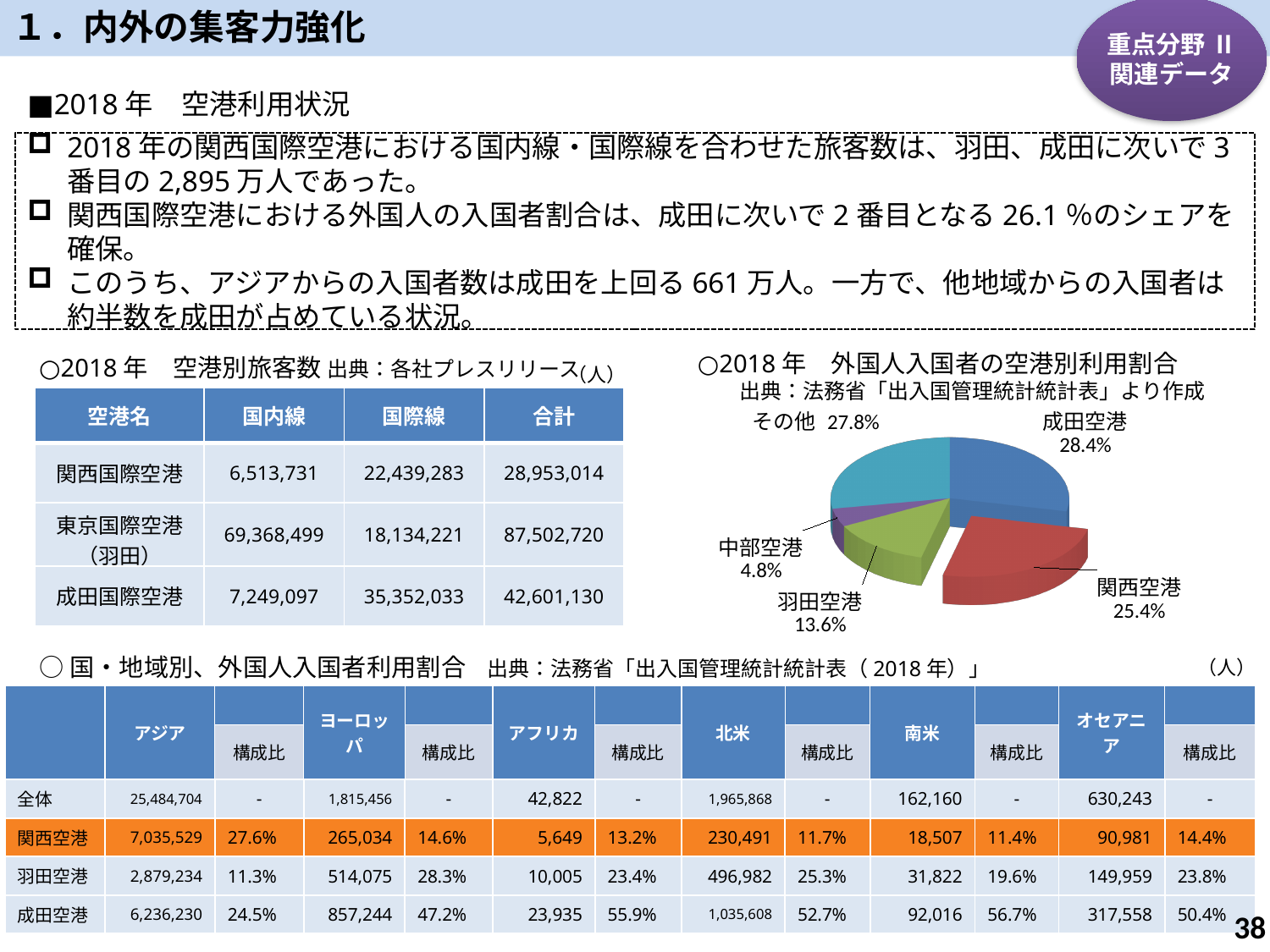
Which slice of the pie chart is the smallest? 中部空港 What is the value shown for 羽田空港 in the pie chart? 13.6% What is the value shown for その他 in the pie chart? 27.8% In the pie chart, what is the difference between the shares of 成田空港 and 関西空港? 3.0% What is the title of the pie chart? 2018年 外国人入国者の空港別利用割合 What share of the pie chart does 成田空港 account for? 28.4% What kind of chart is shown on the slide? pie chart What is the value shown for 関西空港 in the pie chart? 25.4% In the pie chart, what is the difference between the shares of 羽田空港 and 中部空港? 8.8% In the pie chart, which is larger: the share of 羽田空港 or the share of 中部空港? 羽田空港 Which slice of the pie chart is the largest? 成田空港 How many slices does the pie chart have? 5